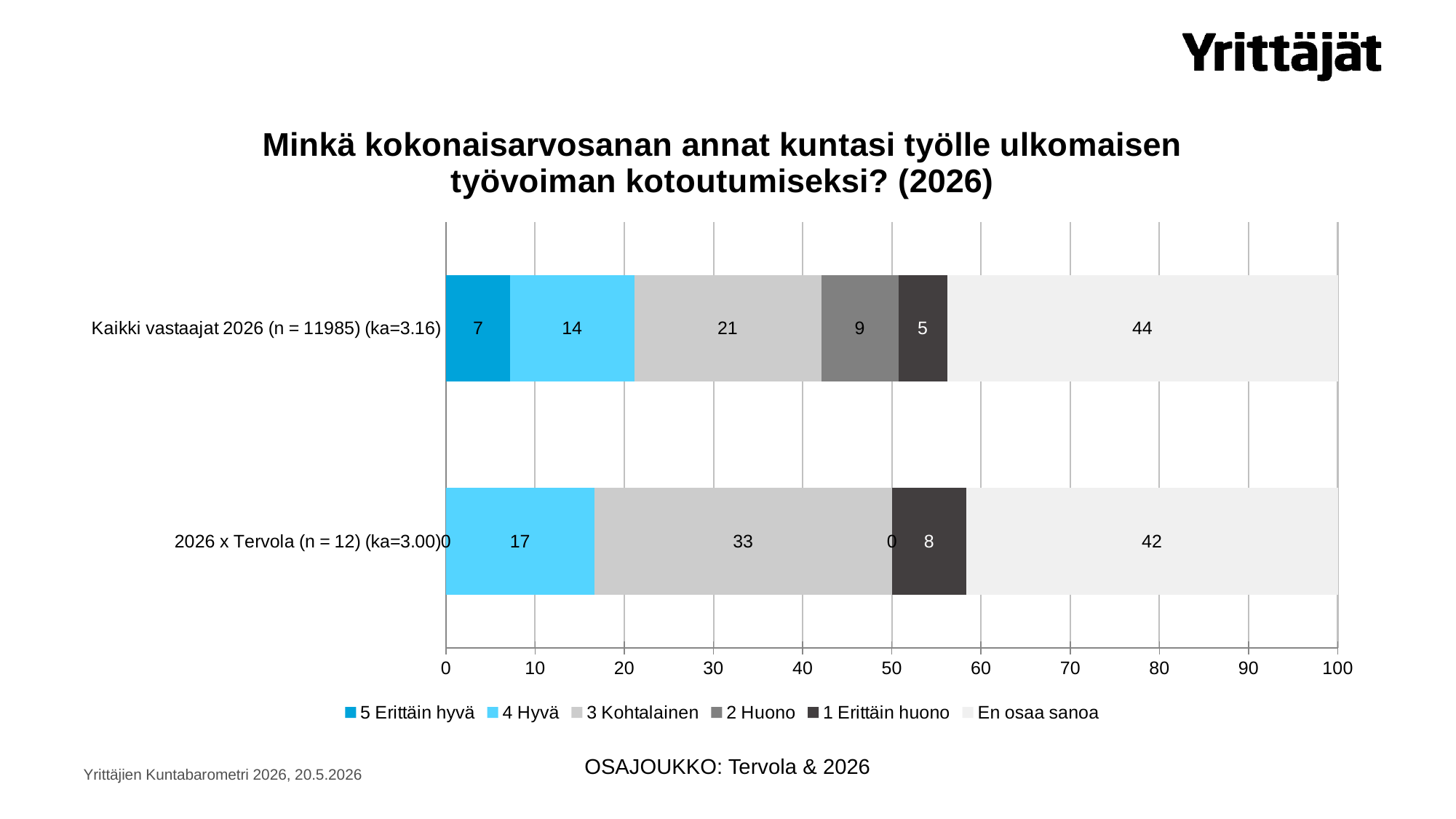
What is the value of "5 Erittäin hyvä" for "2026 x Tervola (n = 12) (ka=3.00)"? 0 What is the difference between the "3 Kohtalainen" values for "2026 x Tervola (n = 12) (ka=3.00)" and "Kaikki vastaajat 2026 (n = 11985) (ka=3.16)"? 12 What is the value of "4 Hyvä" for "2026 x Tervola (n = 12) (ka=3.00)"? 17 What is the total of the stacked bar for "Kaikki vastaajat 2026 (n = 11985) (ka=3.16)"? 100 Which series has the lowest value for "Kaikki vastaajat 2026 (n = 11985) (ka=3.16)"? 1 Erittäin huono How many categories (bars) are shown on the chart? 2 What is the value of "En osaa sanoa" for "2026 x Tervola (n = 12) (ka=3.00)"? 42 What kind of chart is shown on the slide? Stacked bar chart What is the value of "3 Kohtalainen" for "Kaikki vastaajat 2026 (n = 11985) (ka=3.16)"? 21 Which category has the larger value for "1 Erittäin huono": "Kaikki vastaajat 2026 (n = 11985) (ka=3.16)" or "2026 x Tervola (n = 12) (ka=3.00)"? 2026 x Tervola (n = 12) (ka=3.00) Which series has the highest value for "Kaikki vastaajat 2026 (n = 11985) (ka=3.16)"? En osaa sanoa How many series does the legend list? 6